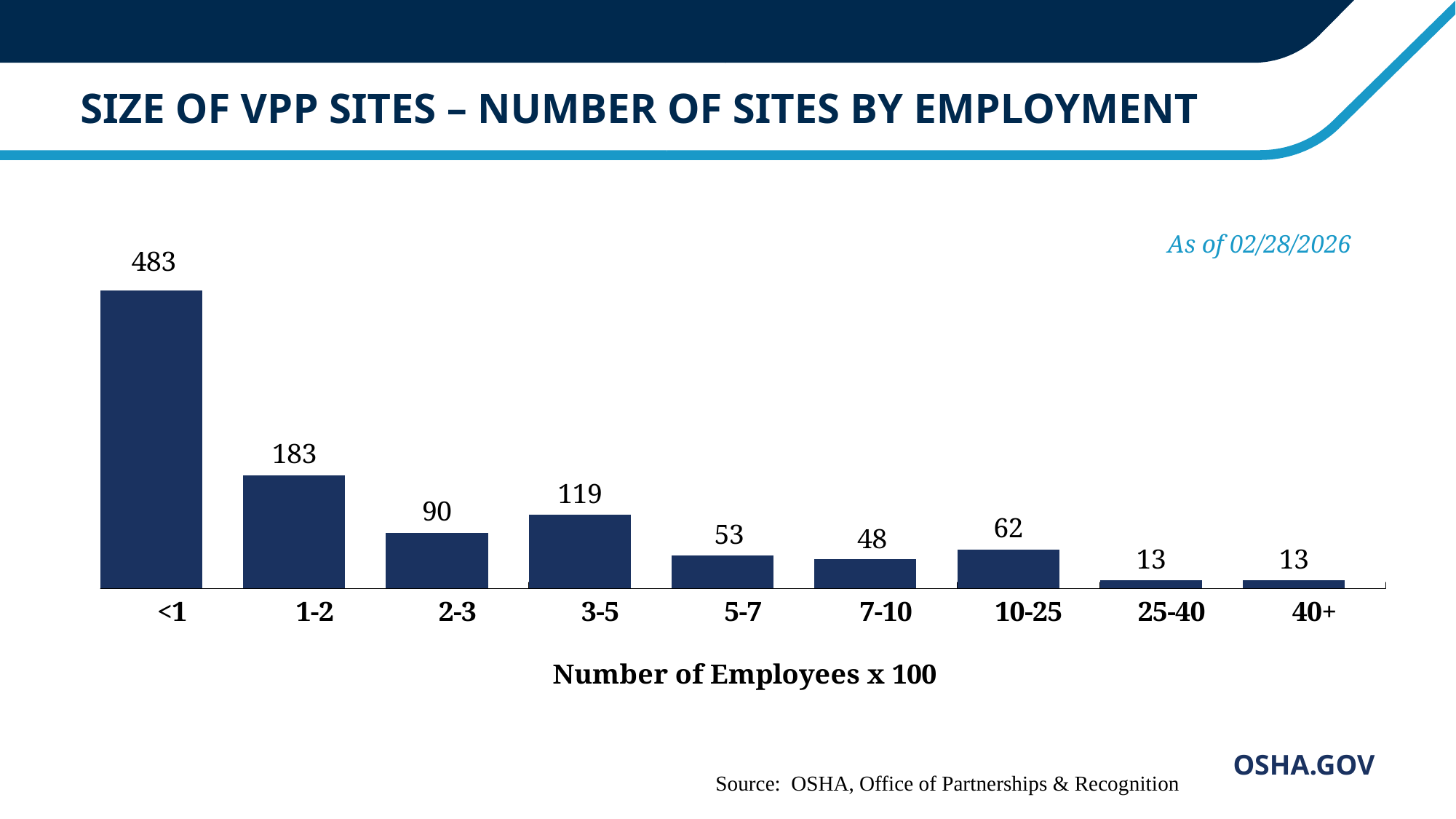
How many employment categories are shown on the x axis? 9 Which employment category has the highest number of sites? <1 As of what date is the chart data reported? 02/28/2026 What is the difference in number of sites between the "<1" and "1-2" categories? 300 What is the label of the x axis? Number of Employees x 100 Which has more sites, the "5-7" category or the "7-10" category? 5-7 What is the number of sites in the "10-25" employment category? 62 What is the difference in number of sites between the "3-5" and "2-3" categories? 29 What kind of chart is shown on the slide? Bar chart Which has more sites, the "2-3" category or the "10-25" category? 2-3 What is the number of sites in the "3-5" employment category? 119 How many VPP sites have fewer than 100 employees (the "<1" category)? 483